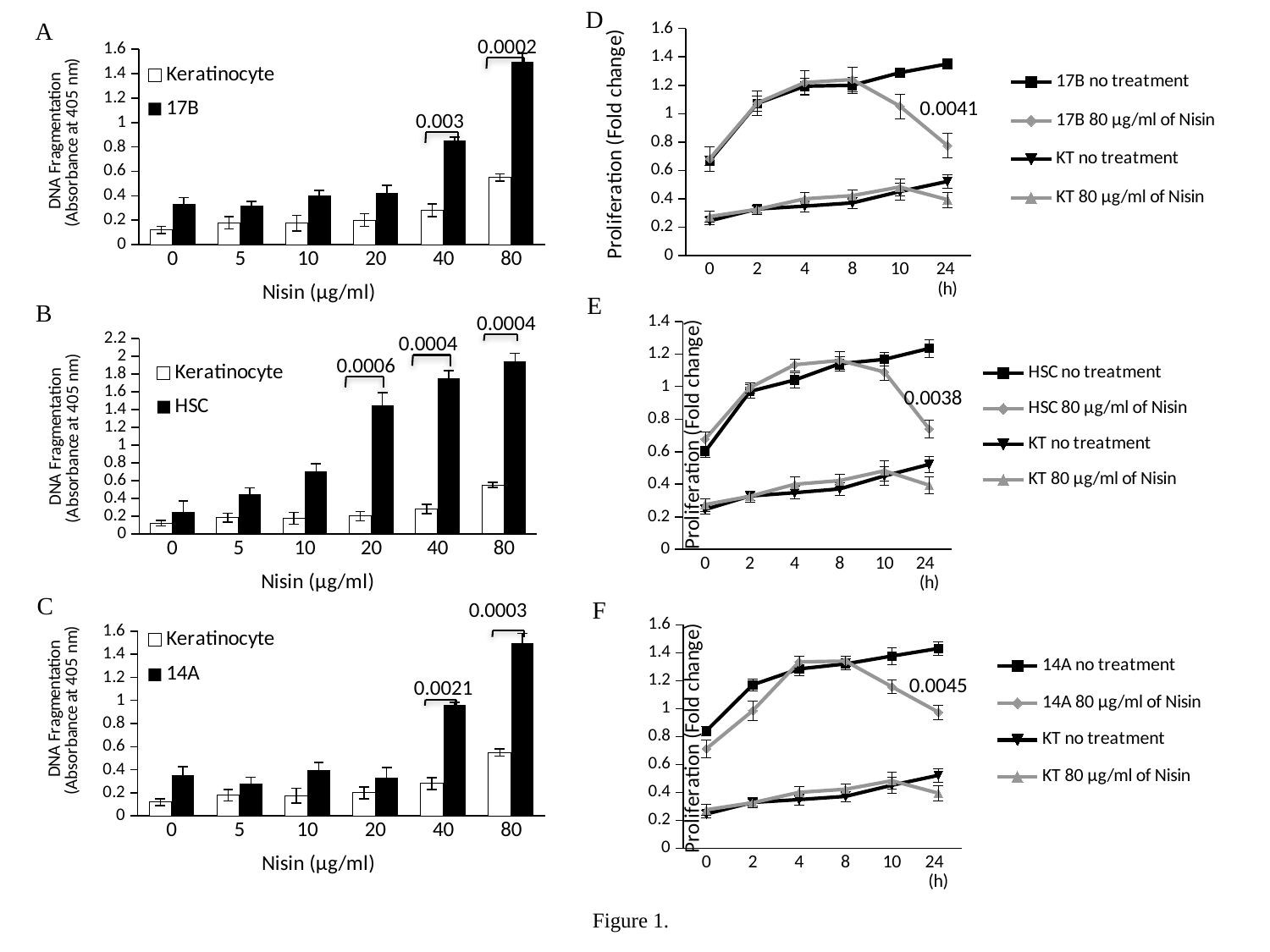
In chart F, what p-value is printed next to the 14A 80 µg/ml of Nisin line? 0.0045 In chart C, what p-value is printed above the bars at 40 µg/ml Nisin? 0.0021 How many Nisin concentration categories are shown on the x axis of chart B? 6 How many series does the legend of chart D list? 4 In chart B, is the HSC value at 80 µg/ml Nisin greater or less than 1.6? greater In chart A, is the 17B value at 80 µg/ml Nisin greater or less than 1.2? greater In chart A, at which Nisin concentration is the 17B bar highest? 80 In chart B, what p-value is printed above the bars at 20 µg/ml Nisin? 0.0006 What kind of chart is chart A (top left)? bar chart What kind of chart is chart D (top right)? line chart In chart A, which is larger at 80 µg/ml Nisin, the Keratinocyte bar or the 17B bar? 17B In chart D, does the '17B no treatment' series rise or fall from 0 h to 24 h? rise